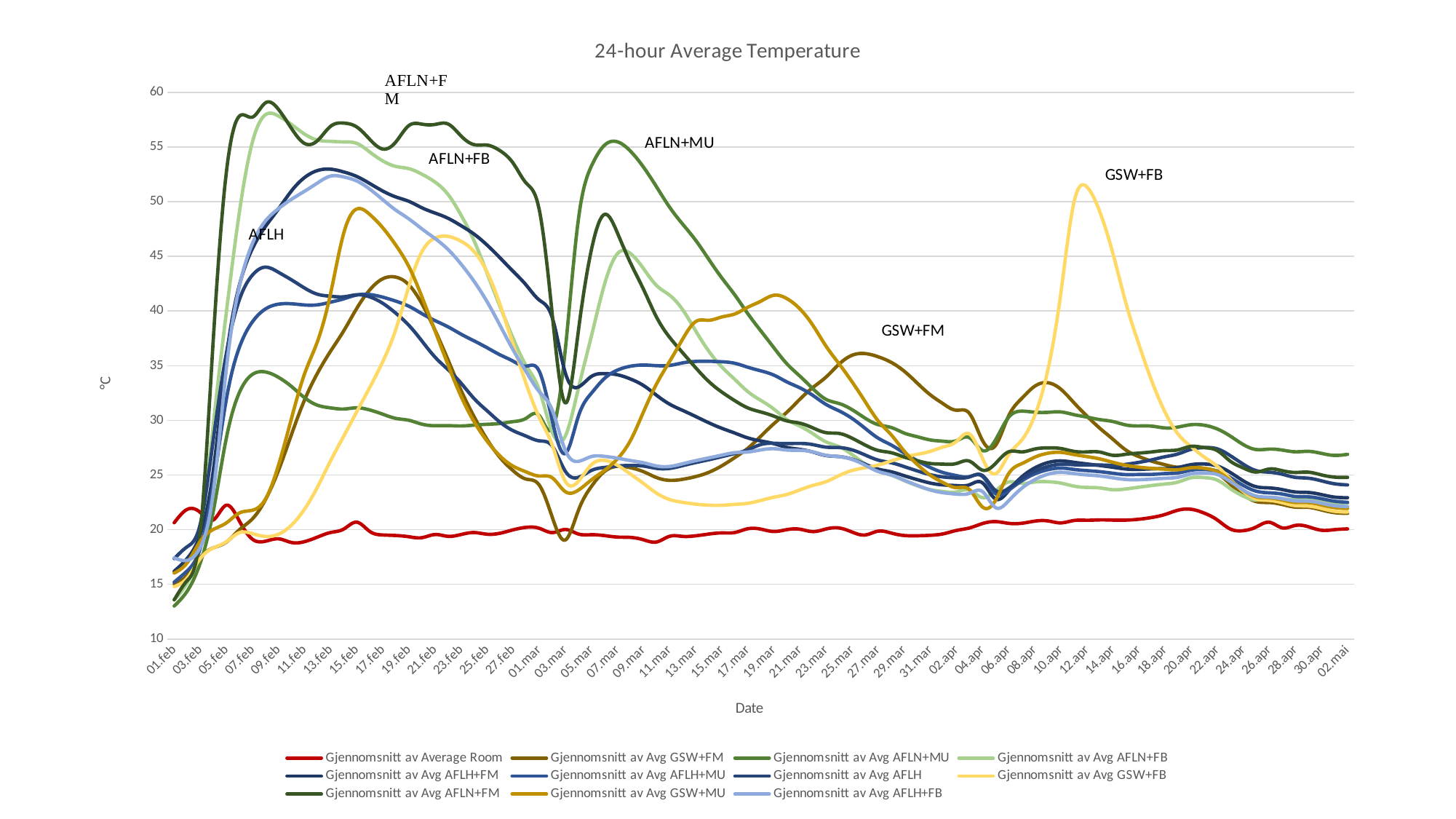
On 15.feb, which is higher: Gjennomsnitt av Avg AFLN+FM or Gjennomsnitt av Average Room? Gjennomsnitt av Avg AFLN+FM Does the Gjennomsnitt av Avg GSW+FB line rise or fall between 12.apr and 20.apr? fall Is the value for Gjennomsnitt av Average Room on 01.mar greater or less than 25? less Is the value for Gjennomsnitt av Avg AFLN+MU on 07.mar greater or less than 50? greater Is the peak value of Gjennomsnitt av Avg GSW+FB around 12.apr greater or less than 45? greater Which series stays lowest across most of the chart? Gjennomsnitt av Average Room What is the label of the vertical axis? °C How many series does the legend list? 11 Does the Gjennomsnitt av Avg AFLN+FM line rise or fall between 01.feb and 07.feb? rise What kind of chart is shown on the slide? line chart What is the title of the chart? 24-hour Average Temperature